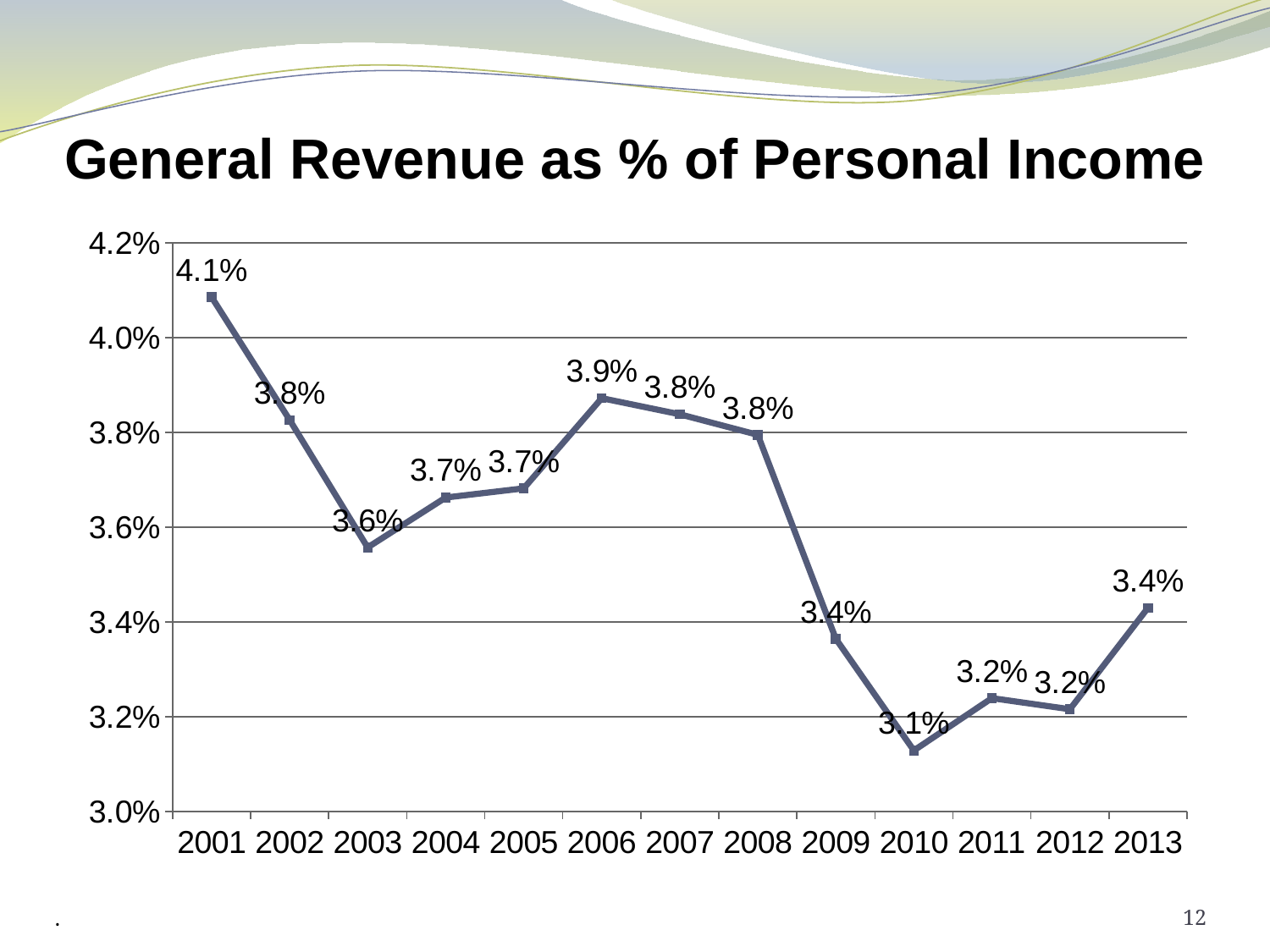
Which year has the lowest value? 2010 What is the difference between the values for 2001 and 2010? 1.0% What is the value for 2006? 3.9% Which is larger, the value for 2006 or the value for 2009? 2006 What is the value for 2001? 4.1% Is the value for 2009 greater or less than 3.6%? less What type of chart is shown on the slide? line chart What is the value for 2010? 3.1% How many years are plotted on the chart? 13 Which year has the highest value? 2001 What is the title of the chart? General Revenue as % of Personal Income What is the value for 2013? 3.4%